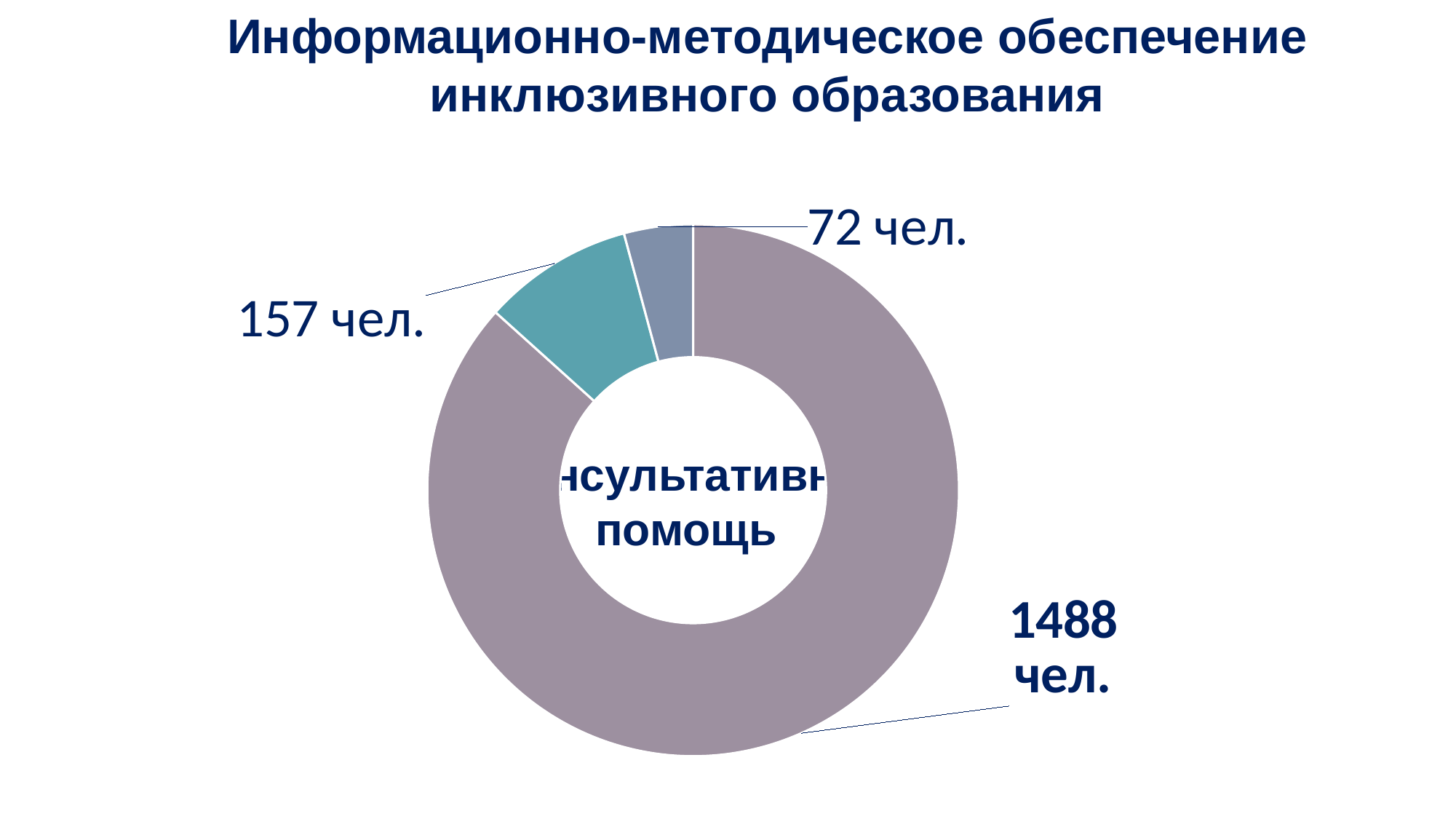
What is the difference between the teal slice (157 чел.) and the blue-grey slice (72 чел.)? 85 чел. Which slice is larger: the teal slice or the blue-grey slice? The teal slice (157 чел.) What value is labelled on the blue-grey slice of the doughnut chart? 72 чел. What is the total of all three slices in the doughnut chart? 1717 чел. How many slices does the doughnut chart have? 3 What kind of chart is shown on the slide? Doughnut (pie) chart What is the value shown for the smallest slice of the doughnut chart? 72 чел. What is the difference between the largest slice (1488 чел.) and the teal slice (157 чел.)? 1331 чел. What is the value shown for the largest slice of the doughnut chart? 1488 чел. What is the title of the slide? Информационно-методическое обеспечение инклюзивного образования What value is labelled on the teal slice of the doughnut chart? 157 чел.